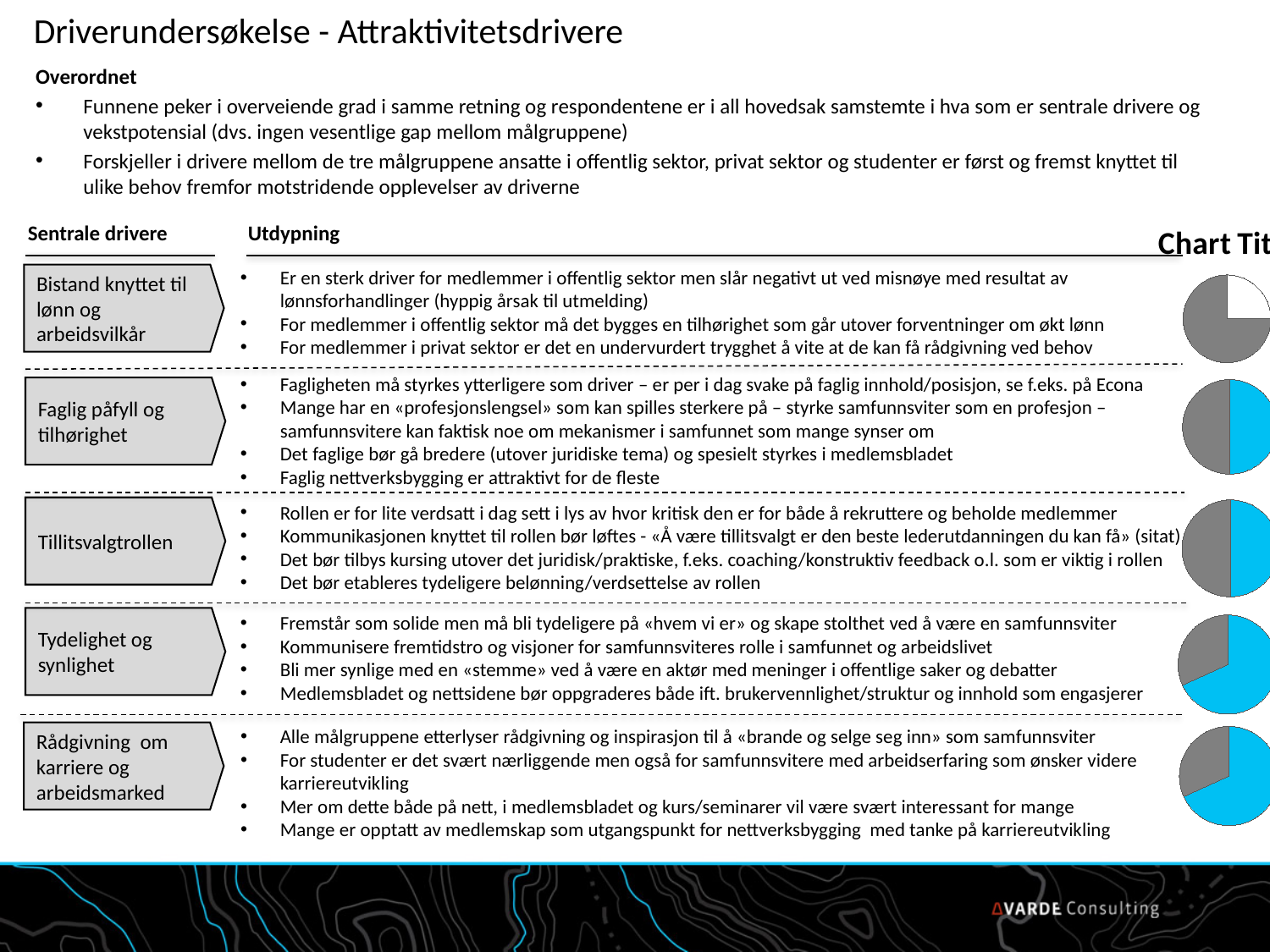
In the fourth pie chart from the top (next to 'Tydelighet og synlighet'), which slice is larger, the cyan one or the grey one? Cyan What kind of charts are shown on the right side of the slide? Pie charts How many pie charts are shown on the right side of the slide? 5 What two colours are used for the slices in the bottom pie chart on the slide? Grey and cyan In the bottom pie chart (next to 'Rådgivning om karriere og arbeidsmarked'), which slice is larger, the cyan one or the grey one? Cyan How many slices does the bottom pie chart (next to 'Rådgivning om karriere og arbeidsmarked') have? 2 Do the pie charts on the slide show any data labels with values? No In the top pie chart (next to 'Bistand knyttet til lønn og arbeidsvilkår'), which slice is larger, the grey one or the white one? Grey